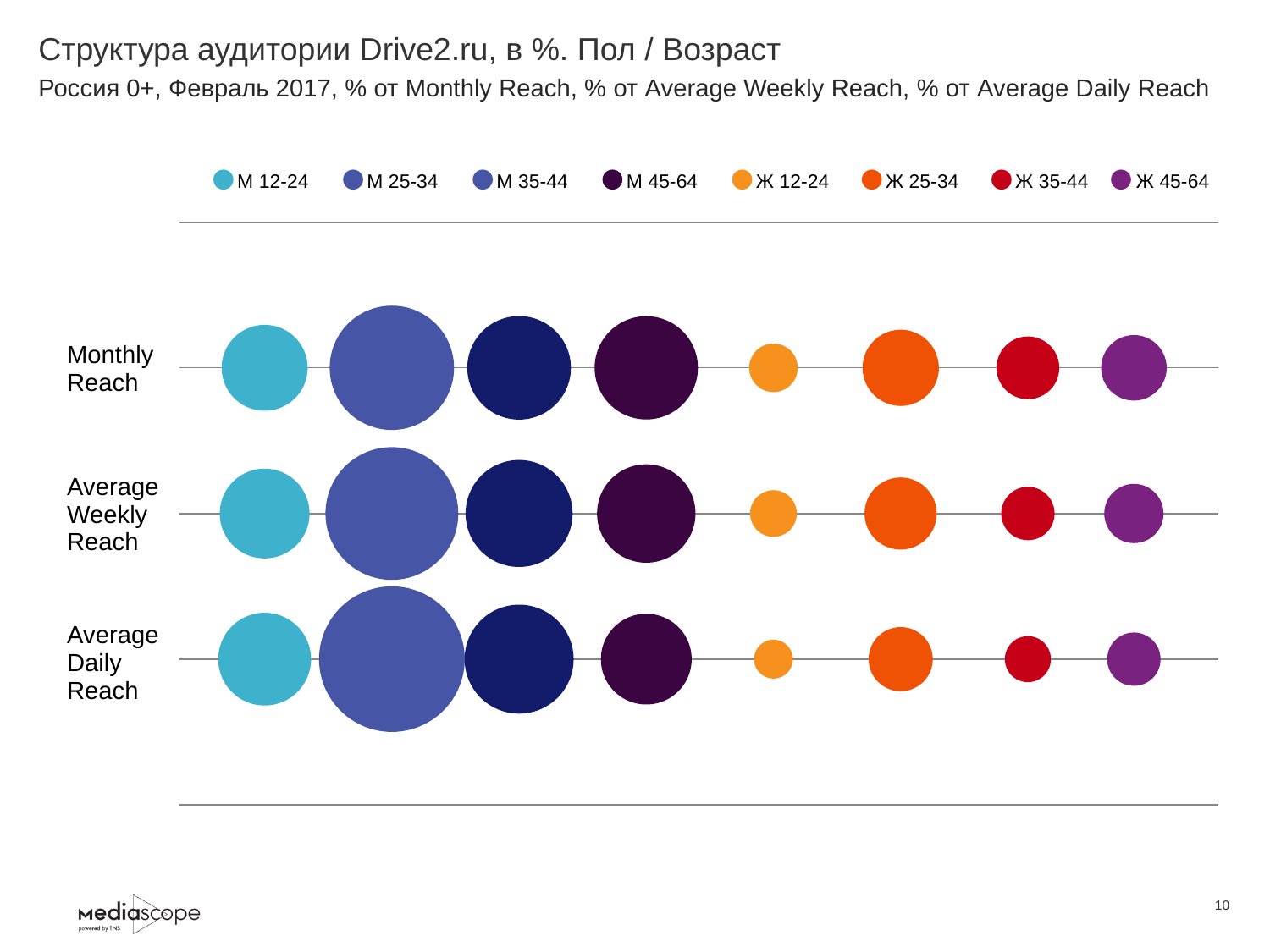
Which audience group has the largest bubble in the Monthly Reach row? М 25-34 In the Average Daily Reach row, which bubble is larger: М 35-44 or Ж 45-64? М 35-44 What is the label of the first row of bubbles on the chart? Monthly Reach How many series does the legend list? 8 What kind of chart is shown on the slide? bubble chart In the Monthly Reach row, which bubble is larger: Ж 25-34 or Ж 12-24? Ж 25-34 Which audience group has the smallest bubble in the Monthly Reach row? Ж 12-24 How many reach rows (categories) are plotted on the chart? 3 Which audience group has the largest bubble in the Average Daily Reach row? М 25-34 In the Average Weekly Reach row, which bubble is larger: М 25-34 or Ж 12-24? М 25-34 Which website's audience structure does the chart title refer to? Drive2.ru